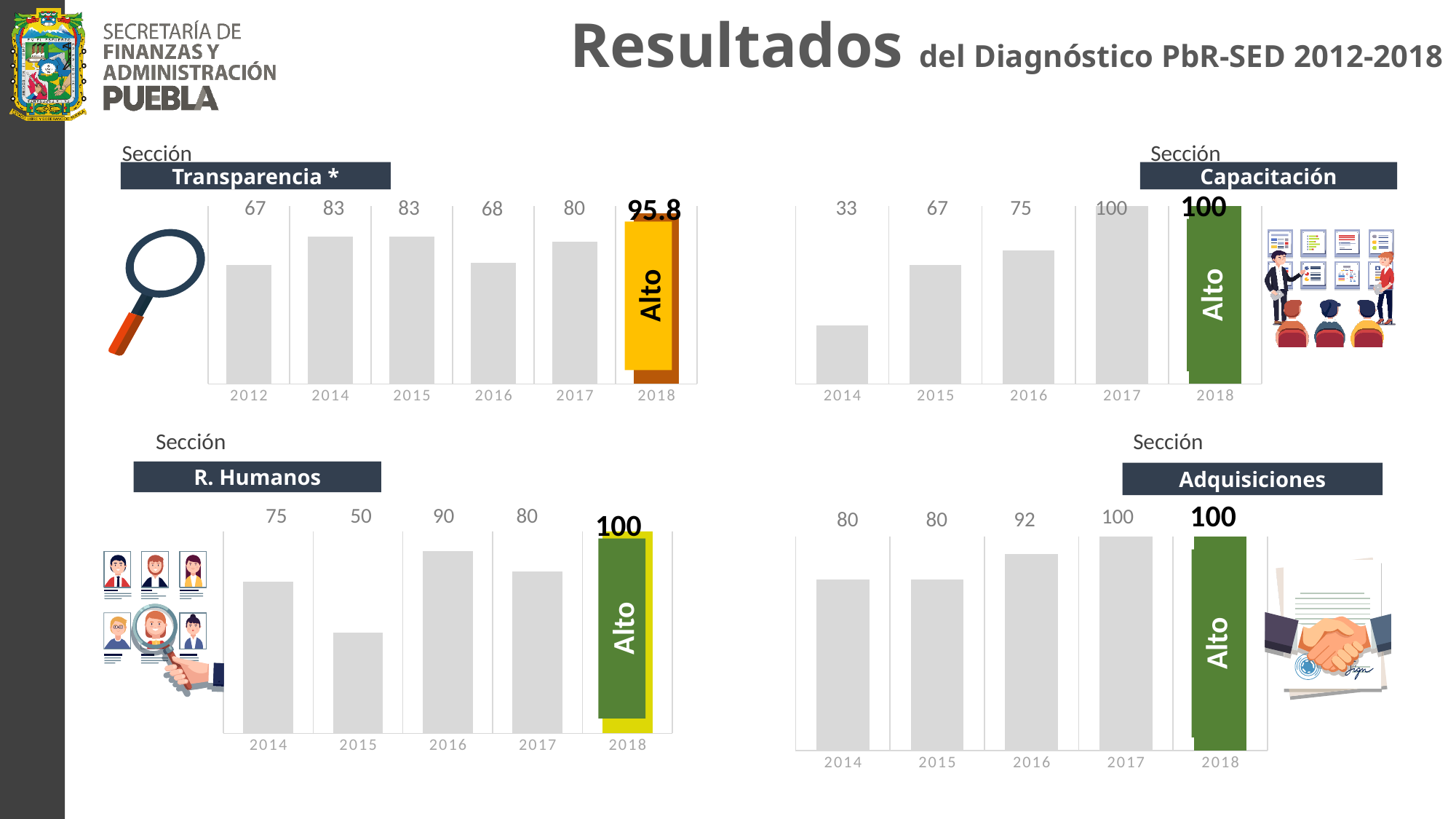
In the Transparencia chart, what is the value for 2018? 95.8 In the R. Humanos chart, what is the value for 2016? 90 In the Adquisiciones chart, what is the value for 2016? 92 In the R. Humanos chart, which year has the lowest value? 2015 In the Capacitación chart, what is the difference between the 2015 and 2014 values? 34 In the Transparencia chart, how many years are plotted? 6 In the Adquisiciones chart, how many years are plotted? 5 In the Capacitación chart, what is the value for 2014? 33 In the R. Humanos chart, is the value for 2016 larger or the value for 2017? 2016 In the Transparencia chart, which year has the lowest value? 2012 What kind of chart is the Adquisiciones chart? bar chart In the Capacitación chart, do the values rise or fall from 2014 to 2017? rise